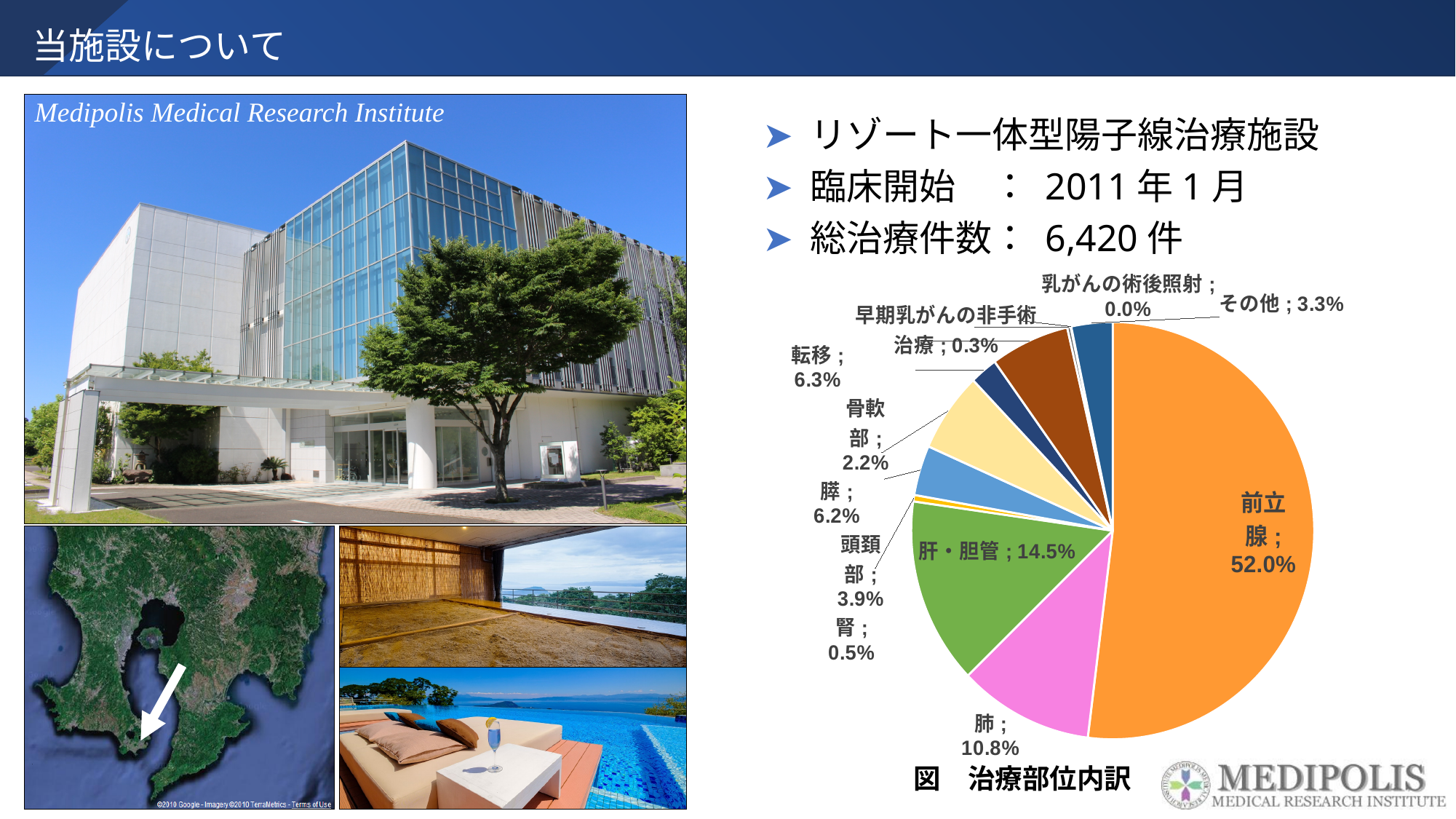
What percentage is shown for 転移 in the pie chart? 6.3% What percentage is shown for 肝・胆管 in the pie chart? 14.5% Which category has the largest slice in the pie chart? 前立腺 What is the difference in percentage points between 頭頚部 and 腎 in the pie chart? 3.4 Which category has the smallest share in the pie chart? 乳がんの術後照射 What is the caption printed below the pie chart? 図 治療部位内訳 What share of the pie chart does 前立腺 account for? 52.0% Which has a larger share in the pie chart, 肺 or 膵? 肺 How many categories are labelled in the pie chart? 11 What percentage is shown for 肺 in the pie chart? 10.8% What is the difference in percentage points between 前立腺 and 肝・胆管 in the pie chart? 37.5 What kind of chart is shown under the heading 図 治療部位内訳? pie chart